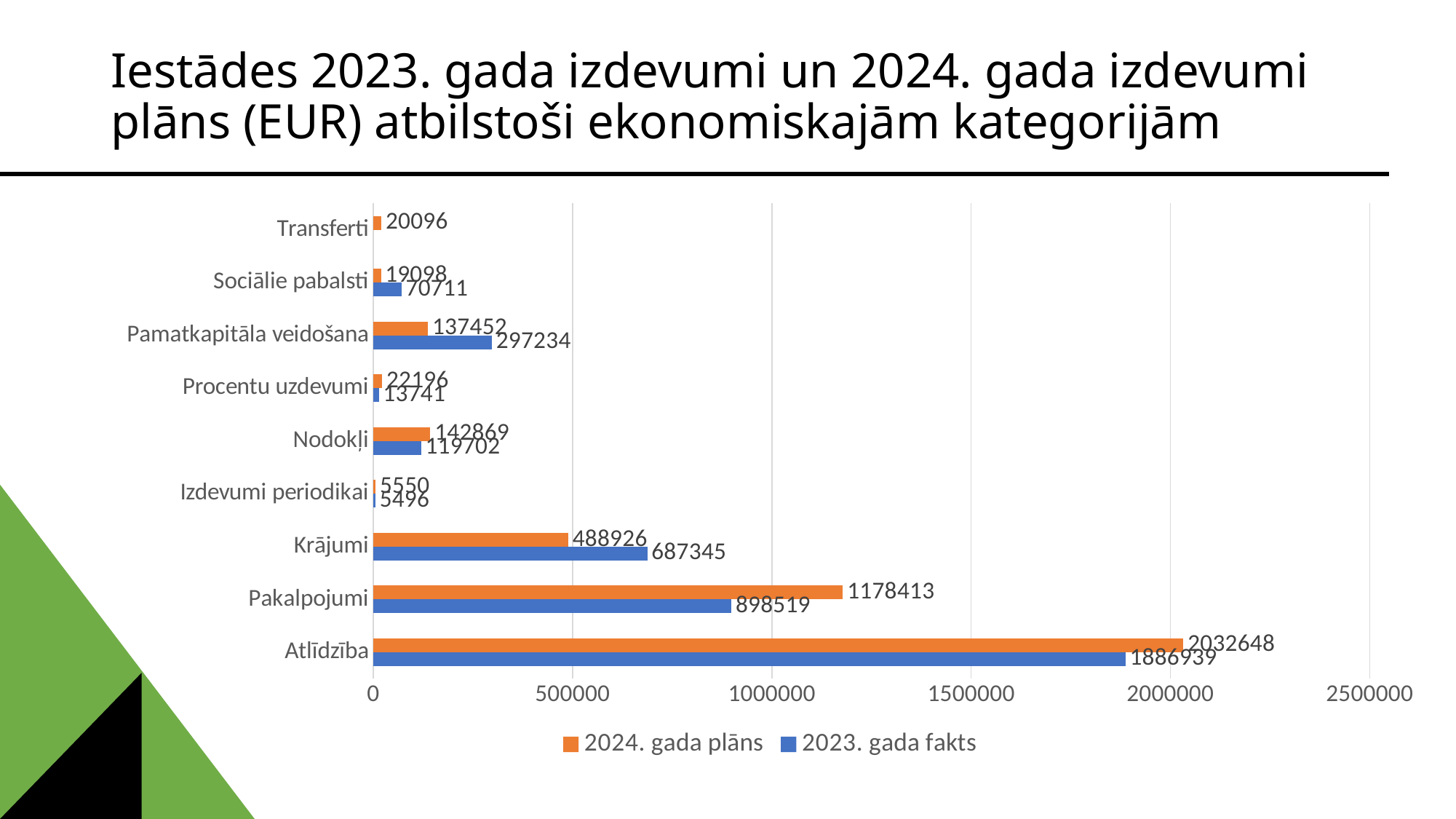
What is the 2024. gada plāns value for Pamatkapitāla veidošana? 137452 How many series does the legend list? 2 What is the 2024. gada plāns value for Atlīdzība? 2032648 What is the 2023. gada fakts value for Pakalpojumi? 898519 What type of chart is shown on the slide? bar chart Which category has the highest 2024. gada plāns value? Atlīdzība What is the difference between the 2024. gada plāns and 2023. gada fakts values for Pakalpojumi? 279894 Is the 2024. gada plāns value for Pakalpojumi greater or less than 1000000? greater What is the difference between the 2024. gada plāns and 2023. gada fakts values for Atlīdzība? 145709 What is the 2023. gada fakts value for Krājumi? 687345 How many categories are shown on the chart? 9 For Krājumi, which is larger: the 2024. gada plāns value or the 2023. gada fakts value? 2023. gada fakts